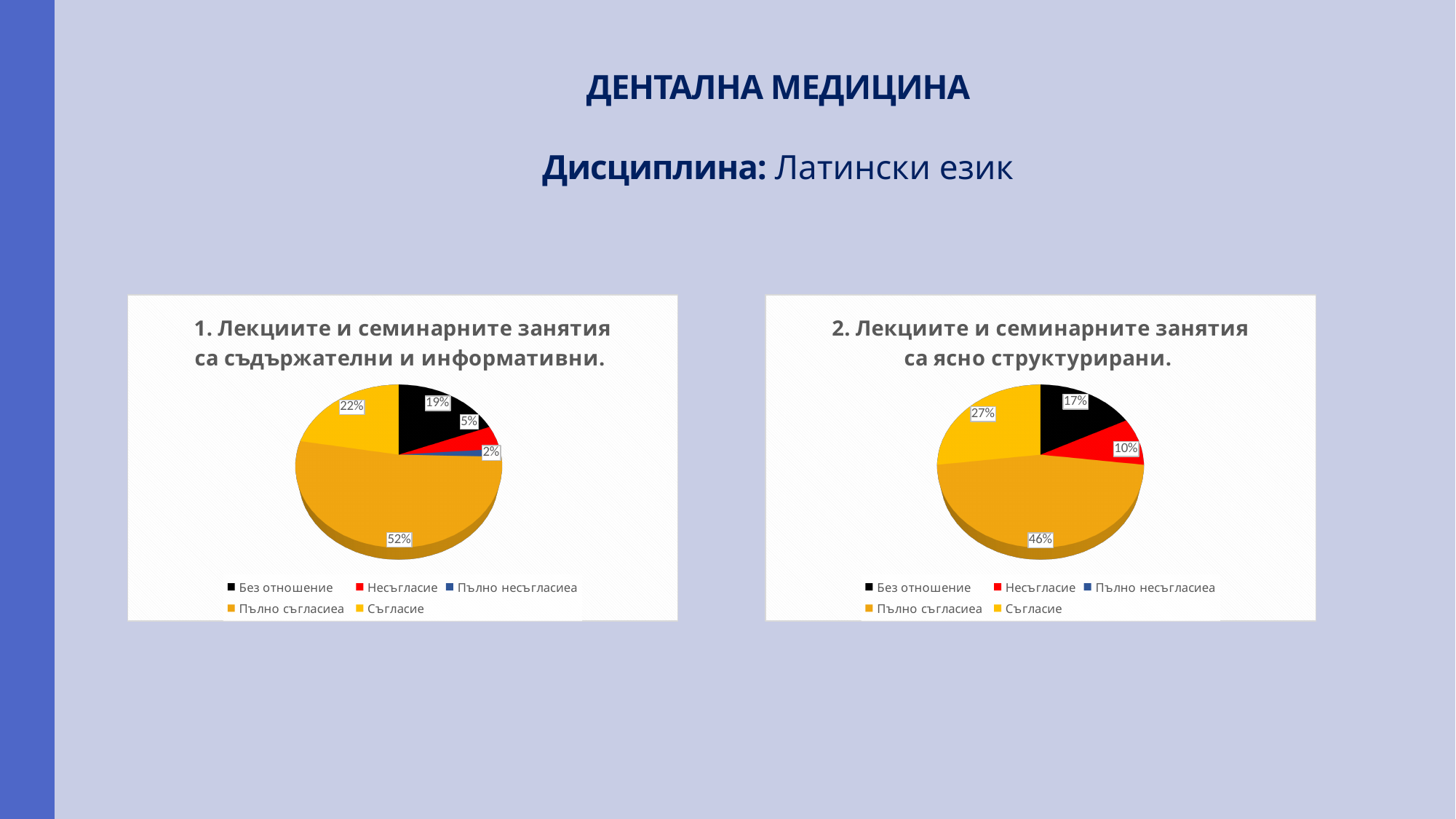
In the right chart ("2. Лекциите и семинарните занятия са ясно структурирани."), what percentage is shown for Съгласие? 27% In the right chart, what percentage is shown for Несъгласие? 10% In the left chart, what percentage is shown for Пълно несъгласиеа? 2% In the left chart, what percentage is shown for Без отношение? 19% In the right chart, which category has the largest slice? Пълно съгласиеа In the right chart, which is larger: Без отношение or Несъгласие? Без отношение How many entries does the legend of the left chart list? 5 In the left chart, which category has the smallest slice? Пълно несъгласиеа In the left chart, what is the difference between the Пълно съгласиеа and Съгласие percentages? 30% In the right chart, what is the combined share of Пълно съгласиеа and Съгласие? 73% In the left chart ("1. Лекциите и семинарните занятия са съдържателни и информативни."), what percentage is shown for Пълно съгласиеа? 52% What type of chart is used on this slide? Pie chart